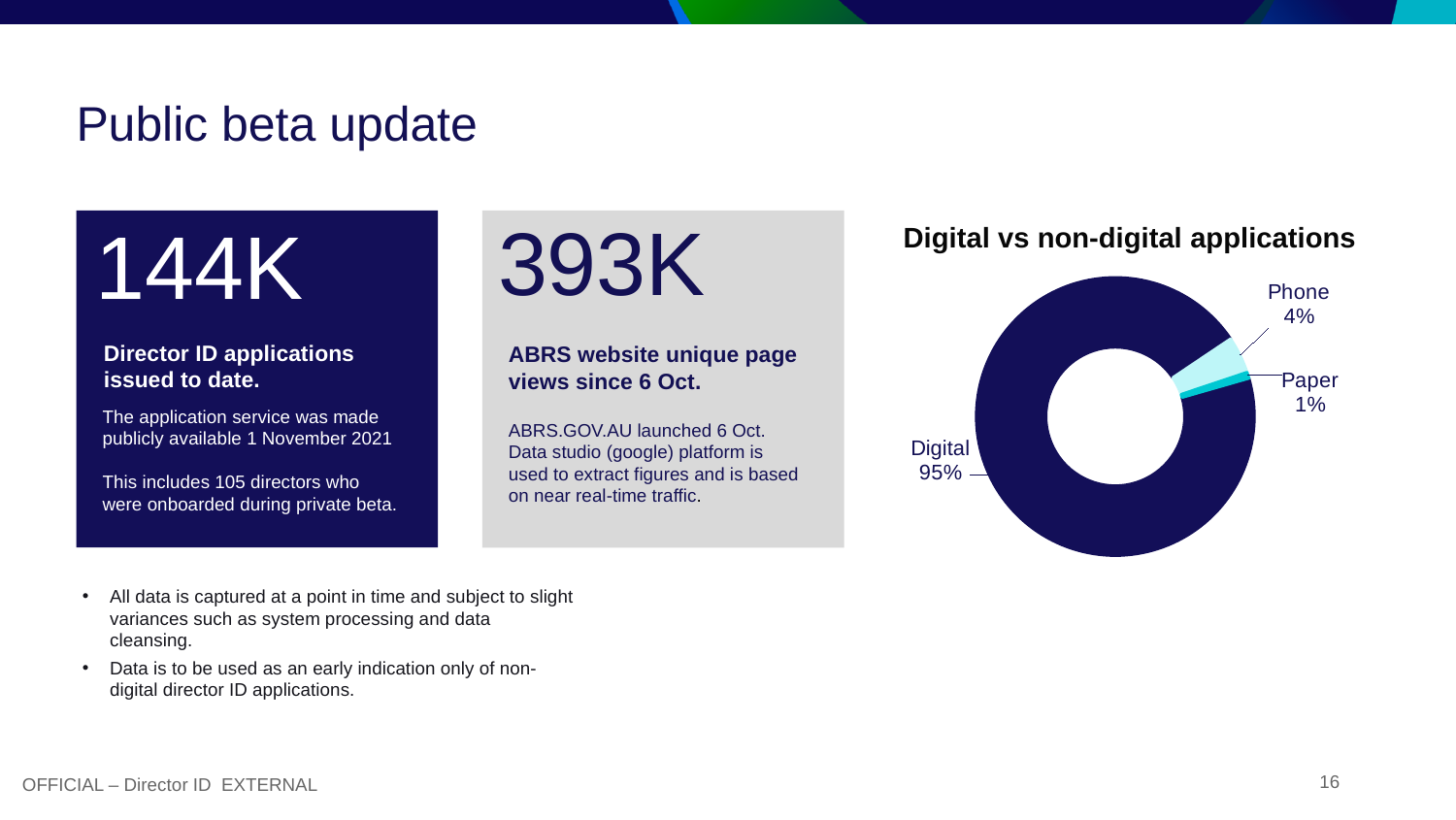
What is the title of the chart on the slide? Digital vs non-digital applications What is the difference in percentage points between the Phone and Paper shares? 3 What kind of chart is shown on the slide? Doughnut (pie) chart What is the combined share of the non-digital (Phone and Paper) applications? 5% What share of applications is Paper? 1% What is the difference in percentage points between the Digital and Phone shares? 91 Which is larger, the Phone share or the Paper share? Phone Which category has the largest share of applications? Digital Which category has the smallest share of applications? Paper What share of applications is Digital? 95% What share of applications is Phone? 4% How many categories are shown in the chart? 3